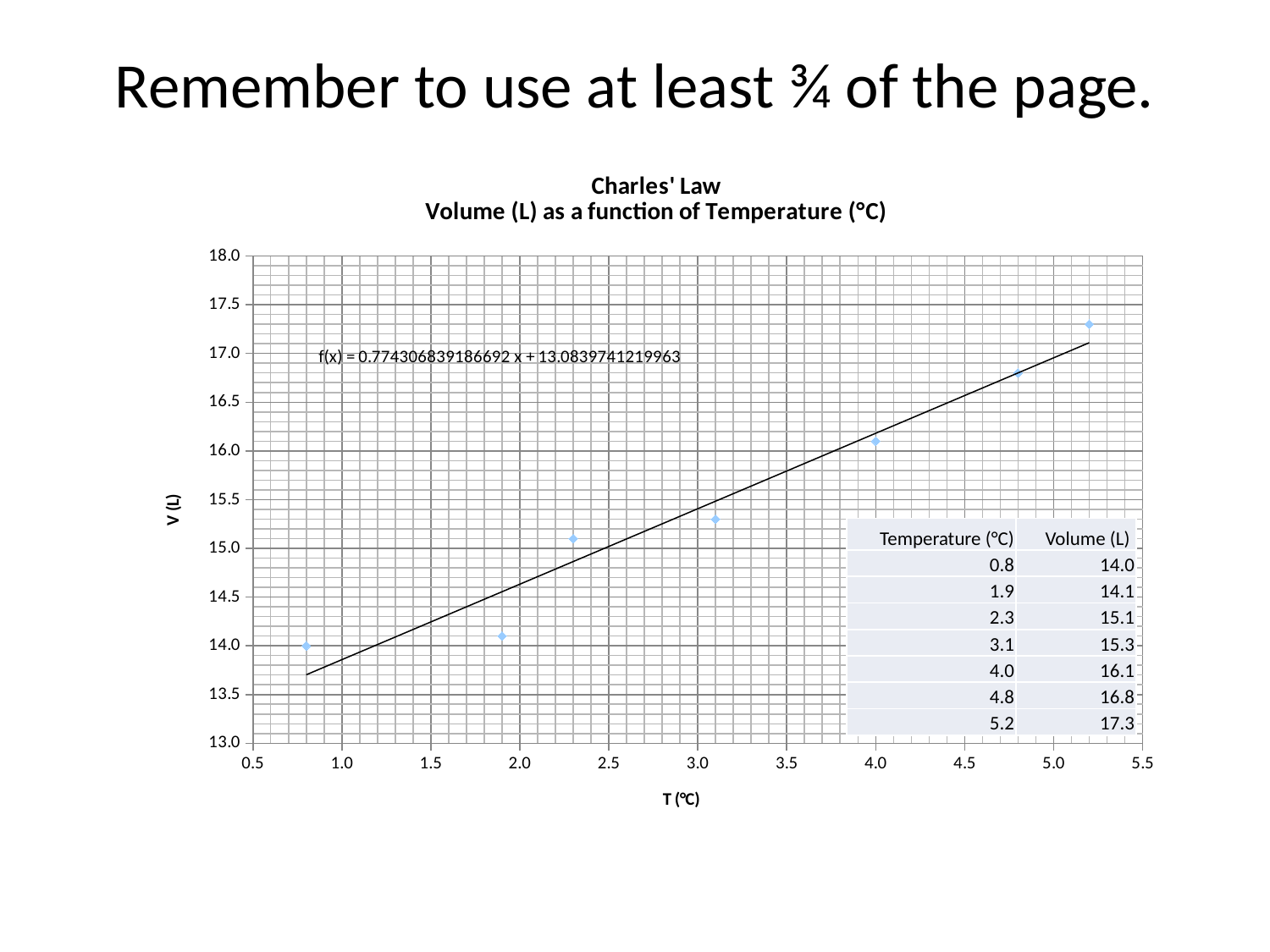
At which temperature is the volume highest? 5.2 At which temperature is the volume lowest? 0.8 What is the title of the chart? Charles' Law Volume (L) as a function of Temperature (°C) How many data points are plotted on the chart? 7 What is the volume (L) at a temperature of 0.8 °C? 14.0 Does the volume rise or fall as temperature increases along the x axis? rise What type of chart is shown on the slide? scatter chart What is the label of the y axis? V (L) What is the volume (L) at a temperature of 4.8 °C? 16.8 Which has a larger volume: the point at 3.1 °C or the point at 4.0 °C? 4.0 °C What is the difference in volume between the points at 5.2 °C and 0.8 °C? 3.3 What is the volume (L) at a temperature of 2.3 °C? 15.1